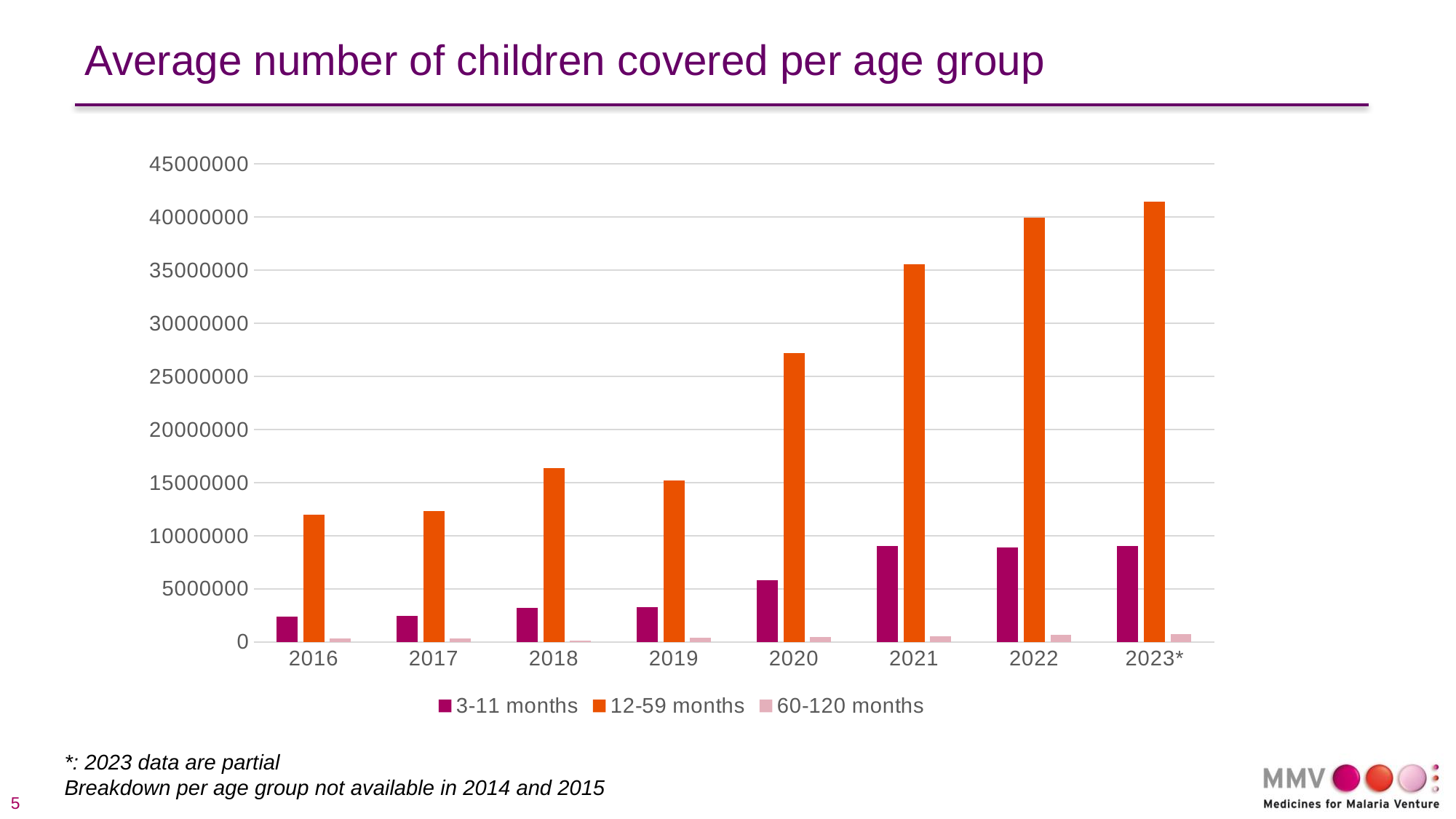
What kind of chart is shown on the slide? Bar chart Does the 12-59 months series generally rise or fall from 2016 to 2023*? rise Is the value for 3-11 months in 2020 greater or less than 5000000? greater How many years are shown on the x axis? 8 Is the value for 12-59 months in 2023* greater or less than 40000000? greater Is the value for 12-59 months in 2020 greater or less than 25000000? greater For the 12-59 months series, which year has the larger value, 2018 or 2019? 2018 What colour represents the 12-59 months series in the legend? Orange How many series does the legend list? 3 Which year has the highest value for the 12-59 months series? 2023*